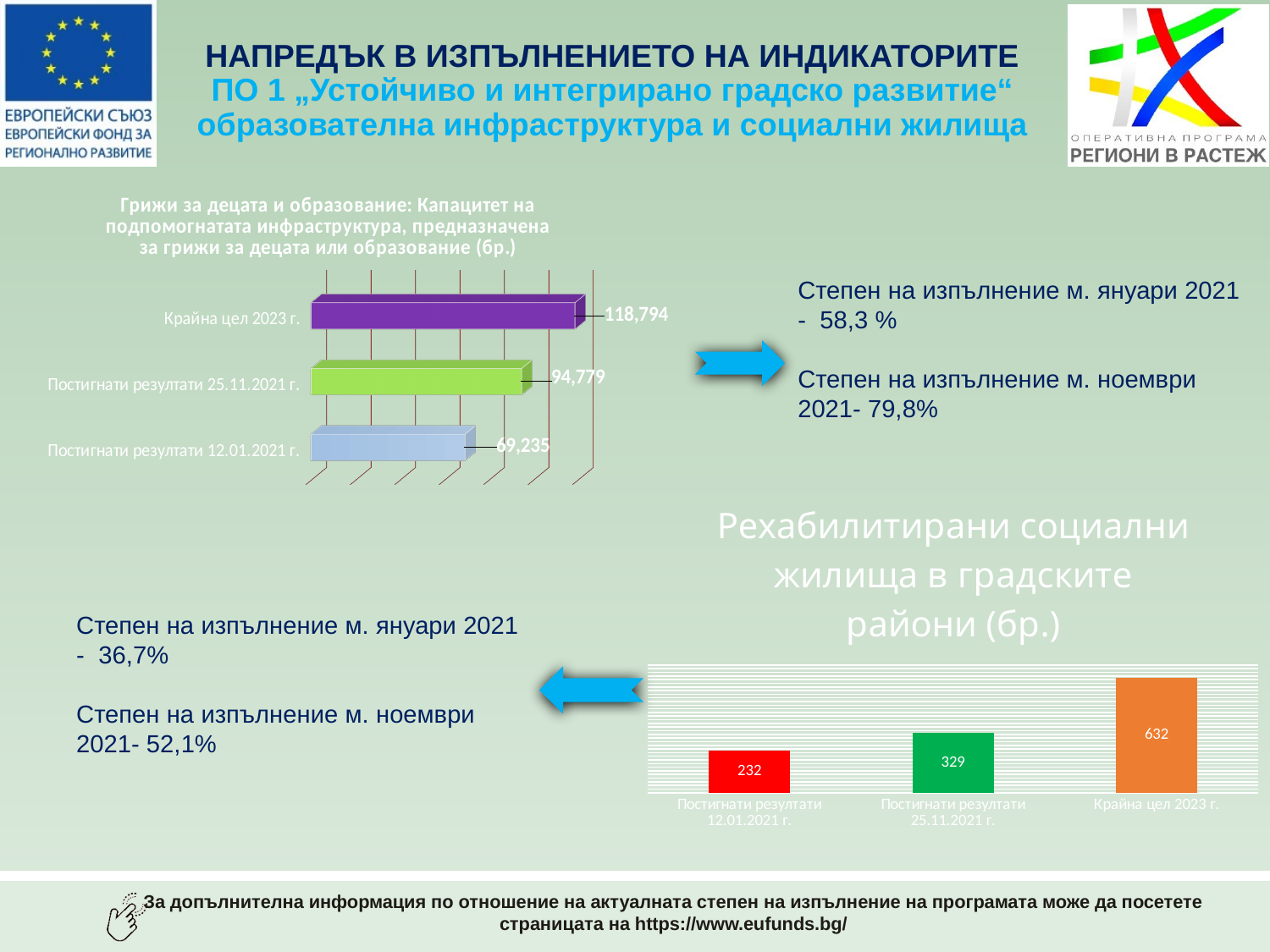
In the chart 'Грижи за децата и образование: Капацитет на подпомогнатата инфраструктура...', what is the value for 'Крайна цел 2023 г.'? 118,794 What type of chart is the chart 'Грижи за децата и образование: Капацитет на подпомогнатата инфраструктура...'? Bar chart In the chart 'Рехабилитирани социални жилища в градските райони (бр.)', what is the value for 'Крайна цел 2023 г.'? 632 In the chart 'Рехабилитирани социални жилища в градските райони (бр.)', what is the value for 'Постигнати резултати 12.01.2021 г.'? 232 In the chart 'Рехабилитирани социални жилища в градските райони (бр.)', what is the difference between 'Постигнати резултати 25.11.2021 г.' and 'Постигнати резултати 12.01.2021 г.'? 97 In the chart 'Рехабилитирани социални жилища в градските райони (бр.)', which category has the highest value? Крайна цел 2023 г. In the chart 'Рехабилитирани социални жилища в градските райони (бр.)', do the values rise or fall from left to right? Rise In the chart 'Грижи за децата и образование: Капацитет на подпомогнатата инфраструктура...', what is the value for 'Постигнати резултати 12.01.2021 г.'? 69,235 In the chart 'Рехабилитирани социални жилища в градските райони (бр.)', how many bars are shown? 3 In the chart 'Грижи за децата и образование: Капацитет на подпомогнатата инфраструктура...', which category has the lowest value? Постигнати резултати 12.01.2021 г. In the chart 'Грижи за децата и образование: Капацитет на подпомогнатата инфраструктура...', what is the value for 'Постигнати резултати 25.11.2021 г.'? 94,779 In the chart 'Грижи за децата и образование: Капацитет на подпомогнатата инфраструктура...', what is the difference between 'Крайна цел 2023 г.' and 'Постигнати резултати 25.11.2021 г.'? 24,015